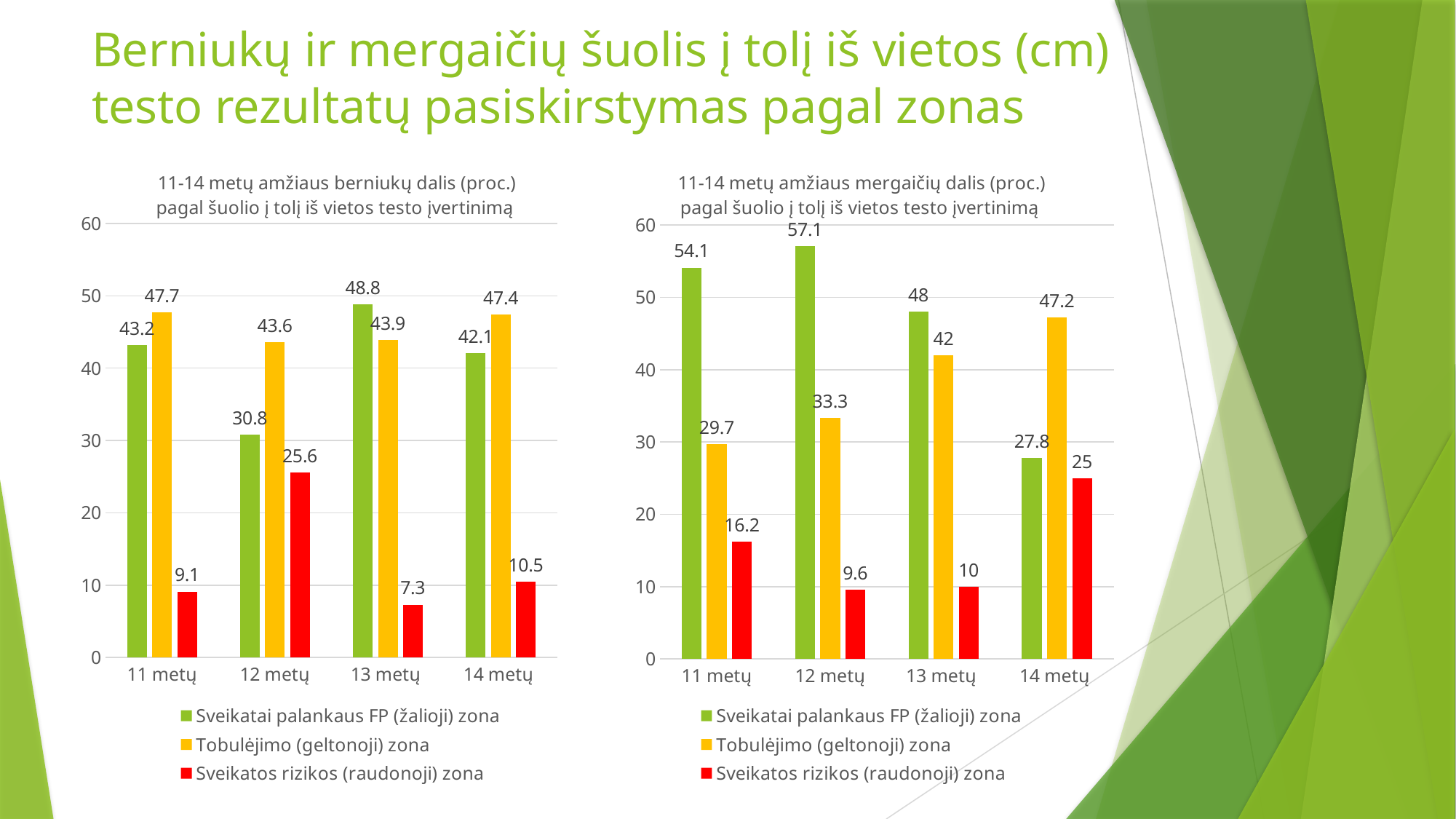
In the right chart (girls), is the value for Sveikatos rizikos (raudonoji) zona at 11 metų greater or less than 20? less In the left chart (boys), what is the value for Sveikatos rizikos (raudonoji) zona at 12 metų? 25.6 What type of chart is the left chart (boys)? bar chart In the right chart (girls), what is the difference between the Sveikatai palankaus FP (žalioji) zona value and the Tobulėjimo (geltonoji) zona value at 11 metų? 24.4 In the right chart (girls), which age group has the lowest value for Sveikatai palankaus FP (žalioji) zona? 14 metų In the right chart (girls), what is the value for Sveikatai palankaus FP (žalioji) zona at 12 metų? 57.1 In the right chart (girls), what is the value for Tobulėjimo (geltonoji) zona at 14 metų? 47.2 How many series does the legend of the right chart (girls) list? 3 How many age groups are shown on the x axis of the left chart (boys)? 4 In the left chart (boys), which is larger at 14 metų: Sveikatai palankaus FP (žalioji) zona or Tobulėjimo (geltonoji) zona? Tobulėjimo (geltonoji) zona In the left chart (boys), which age group has the lowest value for Sveikatos rizikos (raudonoji) zona? 13 metų In the left chart (boys), which age group has the highest value for Sveikatai palankaus FP (žalioji) zona? 13 metų